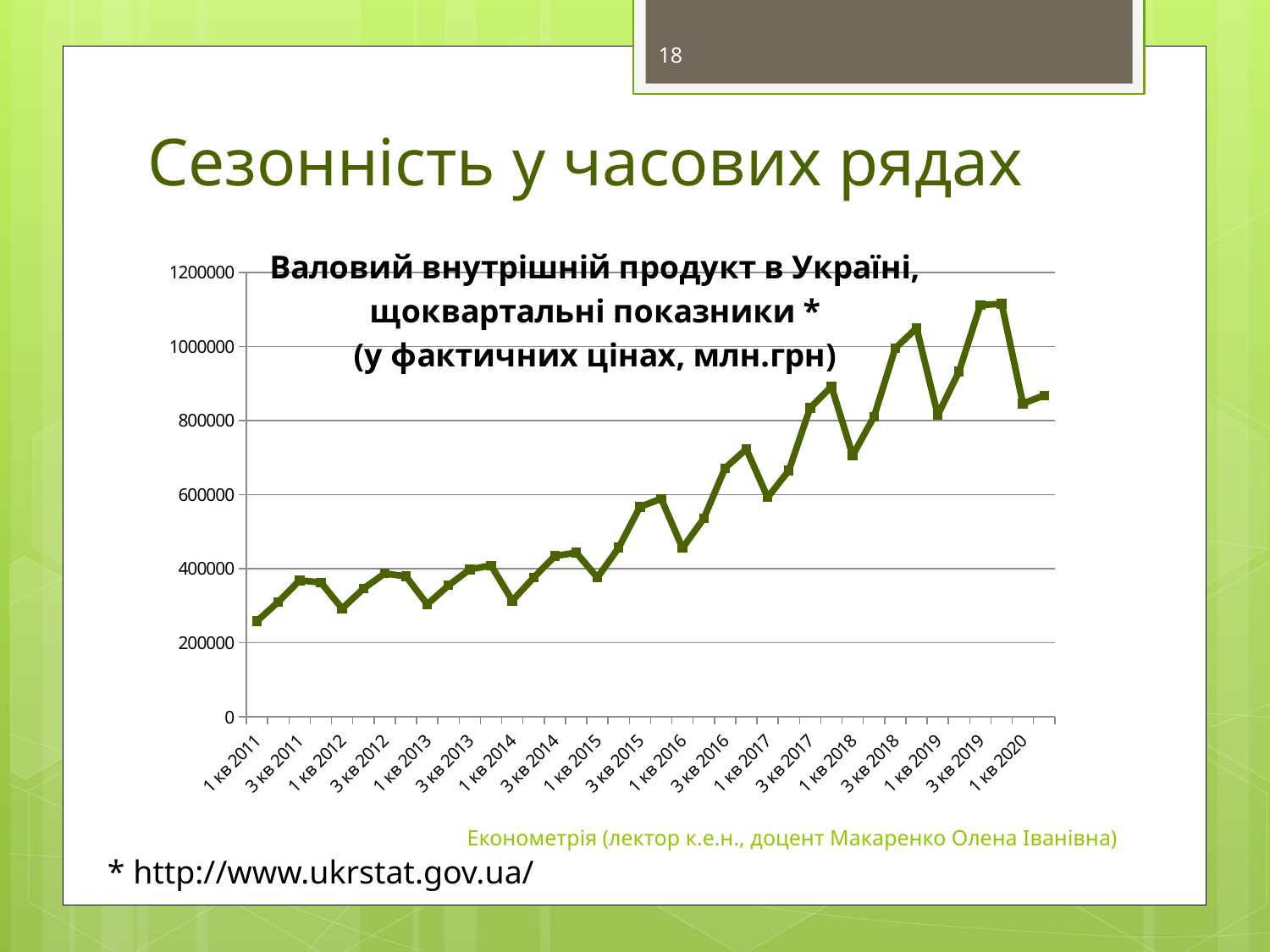
Overall, do the values rise or fall from 1 кв 2011 to 1 кв 2020? rise In what units are the values on the chart expressed, according to the chart title? млн.грн Is the value for 1 кв 2020 greater or less than 800000? greater Is the value for 1 кв 2014 greater or less than 400000? less Which is larger, the value for 1 кв 2011 or the value for 1 кв 2020? 1 кв 2020 Is the value for 1 кв 2018 greater or less than 800000? less Which is larger, the value for 3 кв 2019 or the value for 1 кв 2018? 3 кв 2019 What kind of chart is shown on the slide? line chart Which quarter has the lowest value on the chart? 1 кв 2011